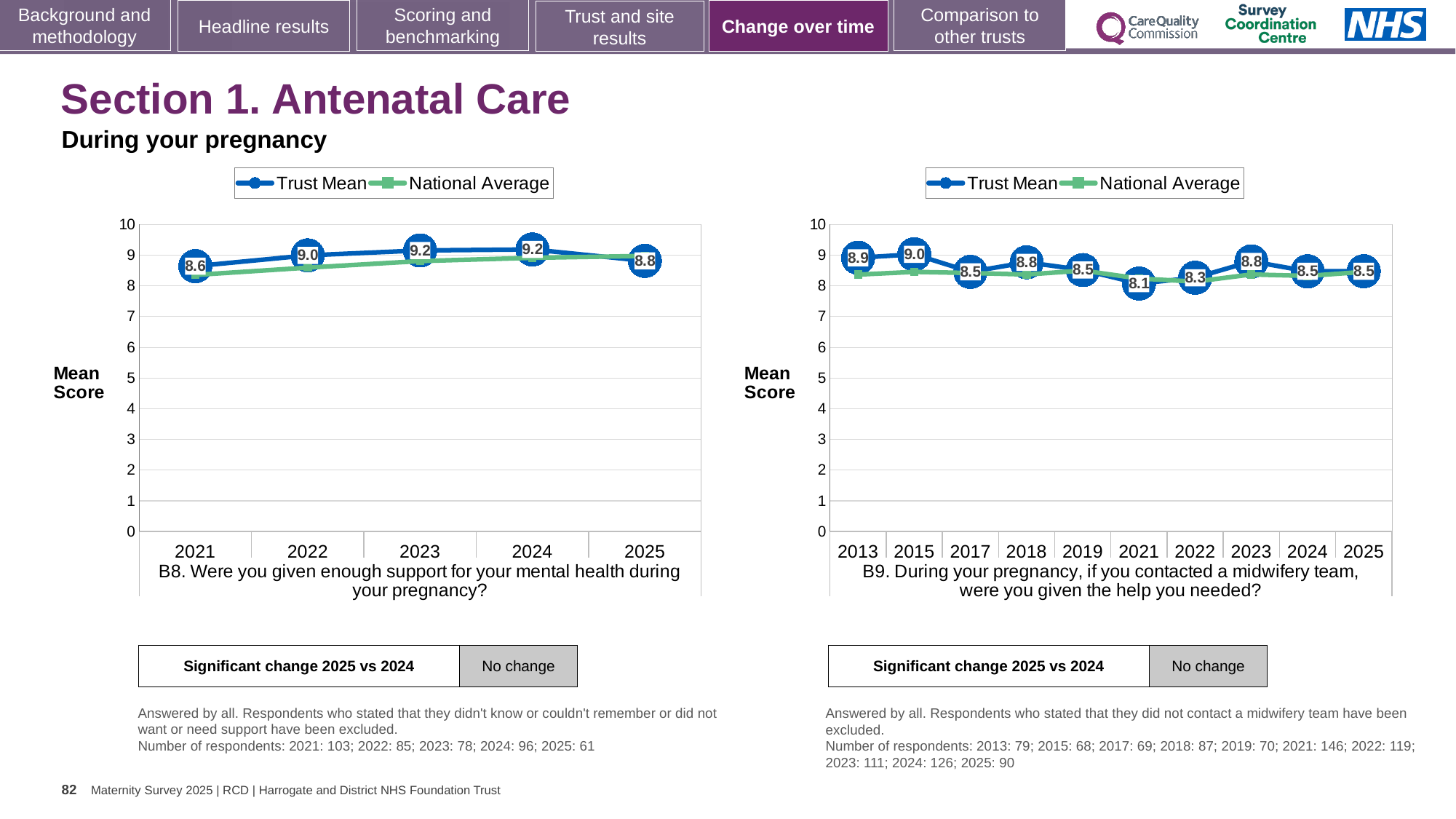
How many series does the legend of the B8 chart on the left list? 2 In the B8 chart on the left, what is the Trust Mean score for 2025? 8.8 In the B8 chart on the left, what is the difference between the Trust Mean scores for 2022 and 2021? 0.4 In the B9 chart on the right, which year has the lowest Trust Mean score? 2021 In the B8 chart on the left, which year has the lowest Trust Mean score? 2021 In the B9 chart on the right, which year has the highest Trust Mean score? 2015 In the B9 chart on the right, how many years are plotted on the x axis? 10 In the B8 chart on the left, how many years are plotted on the x axis? 5 In the B9 chart on the right, what is the Trust Mean score for 2021? 8.1 In the B8 chart on the left, what is the Trust Mean score for 2023? 9.2 What kind of chart is the B9 chart on the right? Line chart In the B9 chart on the right, is the Trust Mean score higher in 2018 or in 2022? 2018